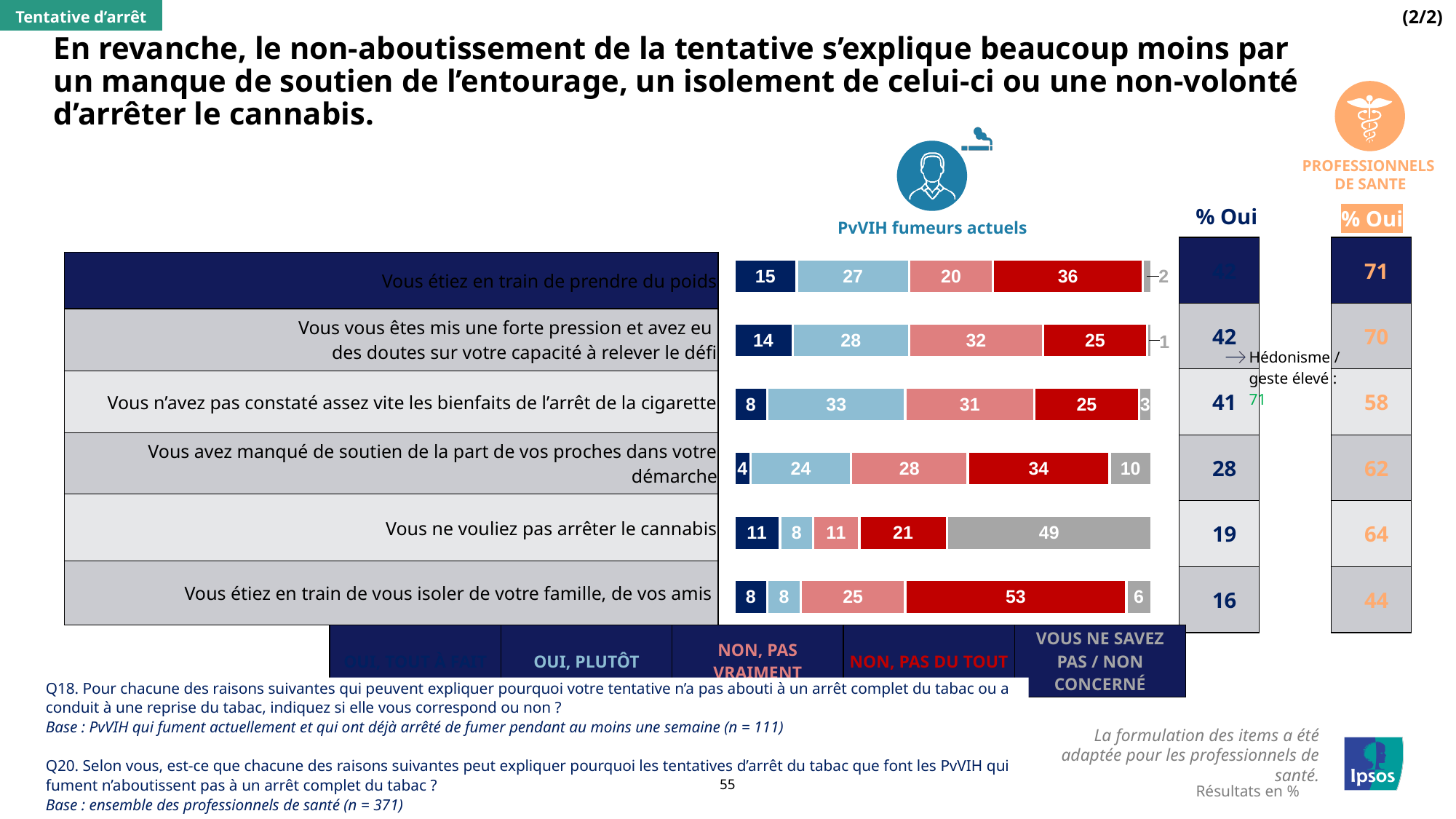
Which reason has the highest 'Non, pas du tout' value? Vous étiez en train de vous isoler de votre famille, de vos amis What is the '% Oui' for professionnels de santé for 'Vous ne vouliez pas arrêter le cannabis'? 64 What kind of chart is used to show the responses for PvVIH fumeurs actuels? Stacked bar chart For 'Vous avez manqué de soutien de la part de vos proches dans votre démarche', what is the difference between the '% Oui' of professionnels de santé and that of PvVIH fumeurs actuels? 34 What is the 'Non, pas du tout' value for 'Vous étiez en train de vous isoler de votre famille, de vos amis'? 53 Which reason has the lowest '% Oui' among PvVIH fumeurs actuels? Vous étiez en train de vous isoler de votre famille, de vos amis What is the total of all segments in the bar for 'Vous avez manqué de soutien de la part de vos proches dans votre démarche'? 100 What is the 'Vous ne savez pas / non concerné' value for 'Vous ne vouliez pas arrêter le cannabis'? 49 How many reasons (categories) are listed in the chart? 6 Which has the larger 'Oui, plutôt' value: 'Vous n'avez pas constaté assez vite les bienfaits de l'arrêt de la cigarette' or 'Vous vous êtes mis une forte pression et avez eu des doutes sur votre capacité à relever le défi'? Vous n'avez pas constaté assez vite les bienfaits de l'arrêt de la cigarette How many response series does the legend list? 5 What population label appears above the stacked bar chart? PvVIH fumeurs actuels